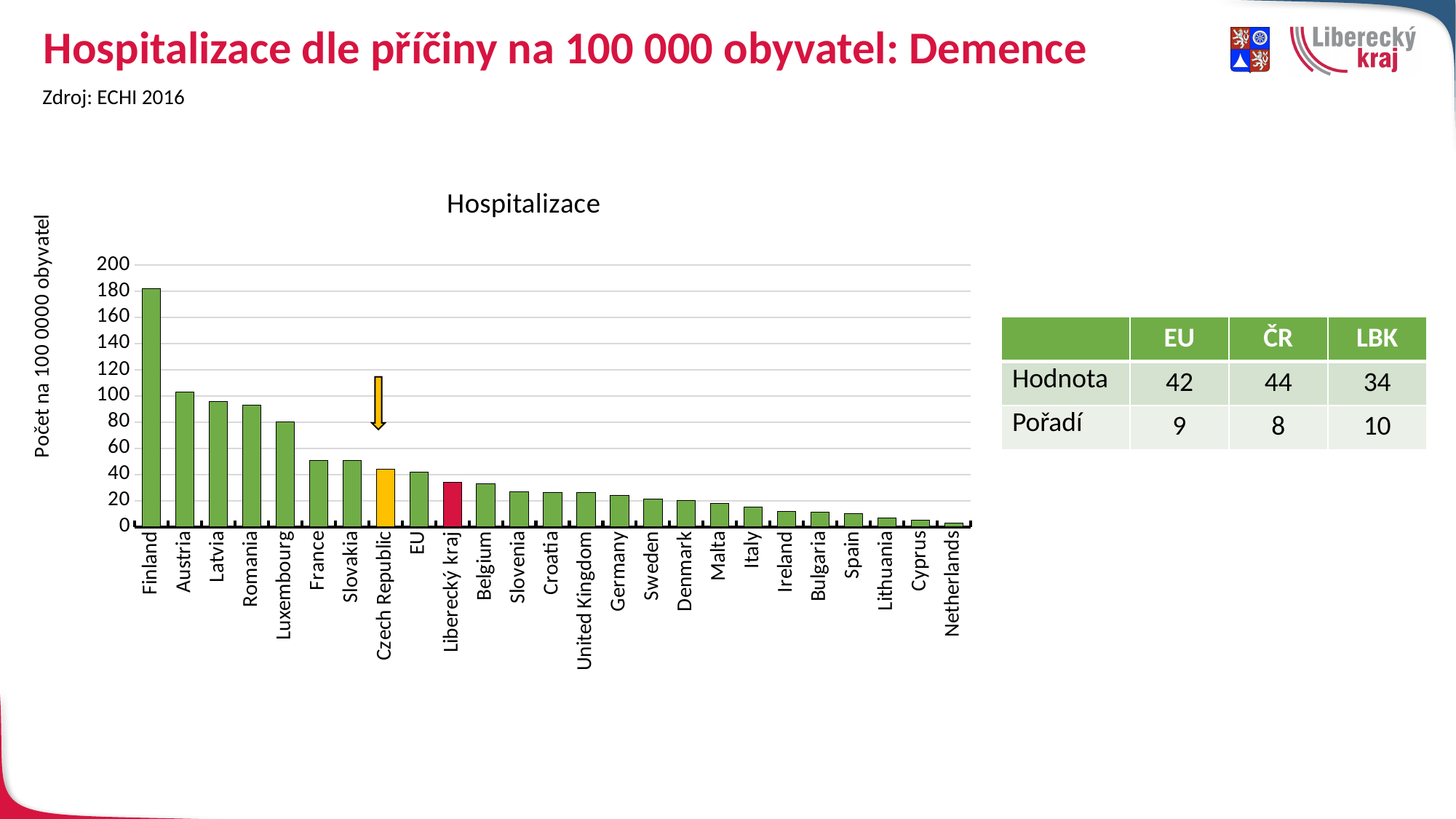
Which country has the lowest hospitalization rate in the chart? Netherlands Is the value for Finland greater or less than 160? greater According to the table, what is the value (Hodnota) for ČR? 44 Which is larger, the value for Finland or the value for Austria? Finland What is the title of the chart? Hospitalizace Do the values rise or fall from left to right along the x axis? fall Is the value for Austria greater or less than 80? greater Which country has the highest hospitalization rate in the chart? Finland How many categories (bars) are shown in the chart? 25 Is the value for Netherlands greater or less than 20? less What kind of chart is shown on the slide? bar chart